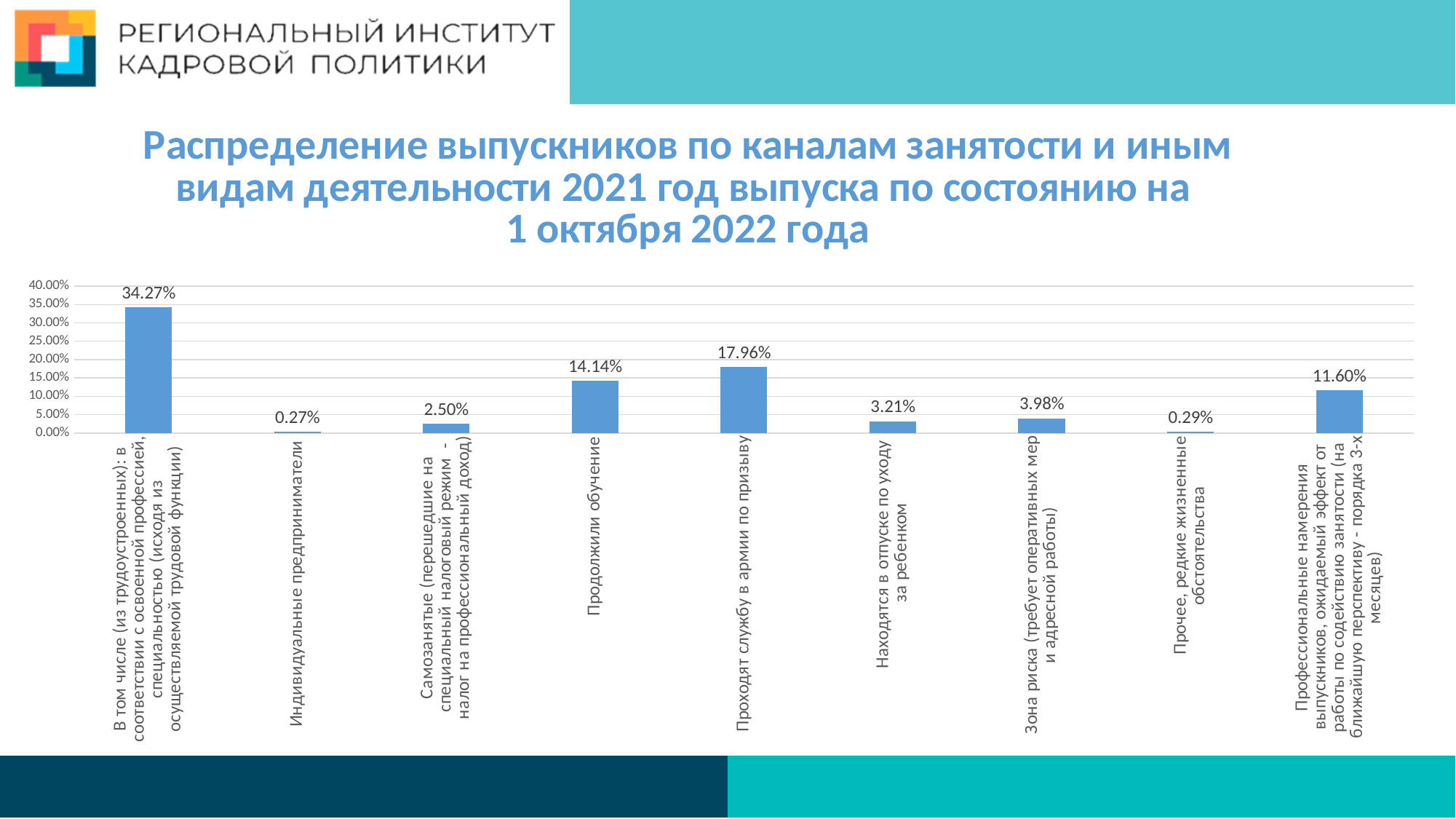
What kind of chart is shown on the slide? bar chart What is the value for "Индивидуальные предприниматели"? 0.27% What is the difference between the value for "Проходят службу в армии по призыву" and the value for "Продолжили обучение"? 3.82% What is the value for "Проходят службу в армии по призыву"? 17.96% What is the value for "Продолжили обучение"? 14.14% Which category has the highest value? В том числе (из трудоустроенных): в соответствии с освоенной профессией, специальностью (исходя из осуществляемой трудовой функции) What is the highest value shown on the vertical axis? 40.00% What is the value for "Находятся в отпуске по уходу за ребенком"? 3.21% How many categories are shown in the chart? 9 Is the value for "Профессиональные намерения выпускников" greater or less than 10.00%? greater Which is larger: the value for "Самозанятые" or the value for "Зона риска"? Зона риска What is the value for "Зона риска (требует оперативных мер и адресной работы)"? 3.98%